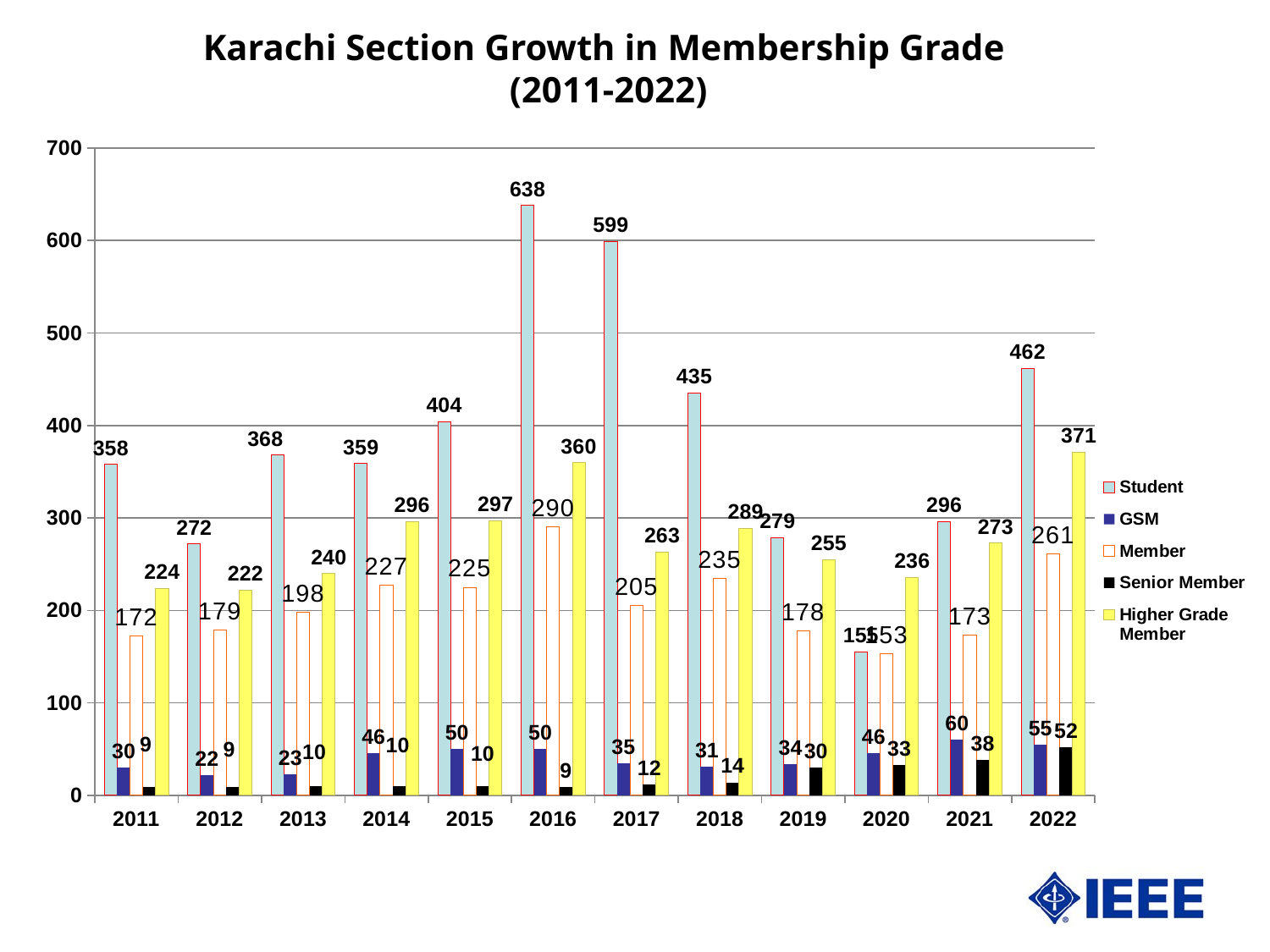
Which colour represents Higher Grade Member in the legend? Yellow How many series does the legend list? 5 What is the Student value for 2016? 638 Is the Member value for 2019 greater or less than 200? less What is the Higher Grade Member value for 2022? 371 What is the difference between the Student values for 2016 and 2017? 39 In which year is the GSM series highest? 2021 In which year is the Senior Member series highest? 2022 In 2016, which is larger: Member or Higher Grade Member? Higher Grade Member In which year is the Student series highest? 2016 How many years are shown on the x axis? 12 What kind of chart is shown on the slide? Bar chart